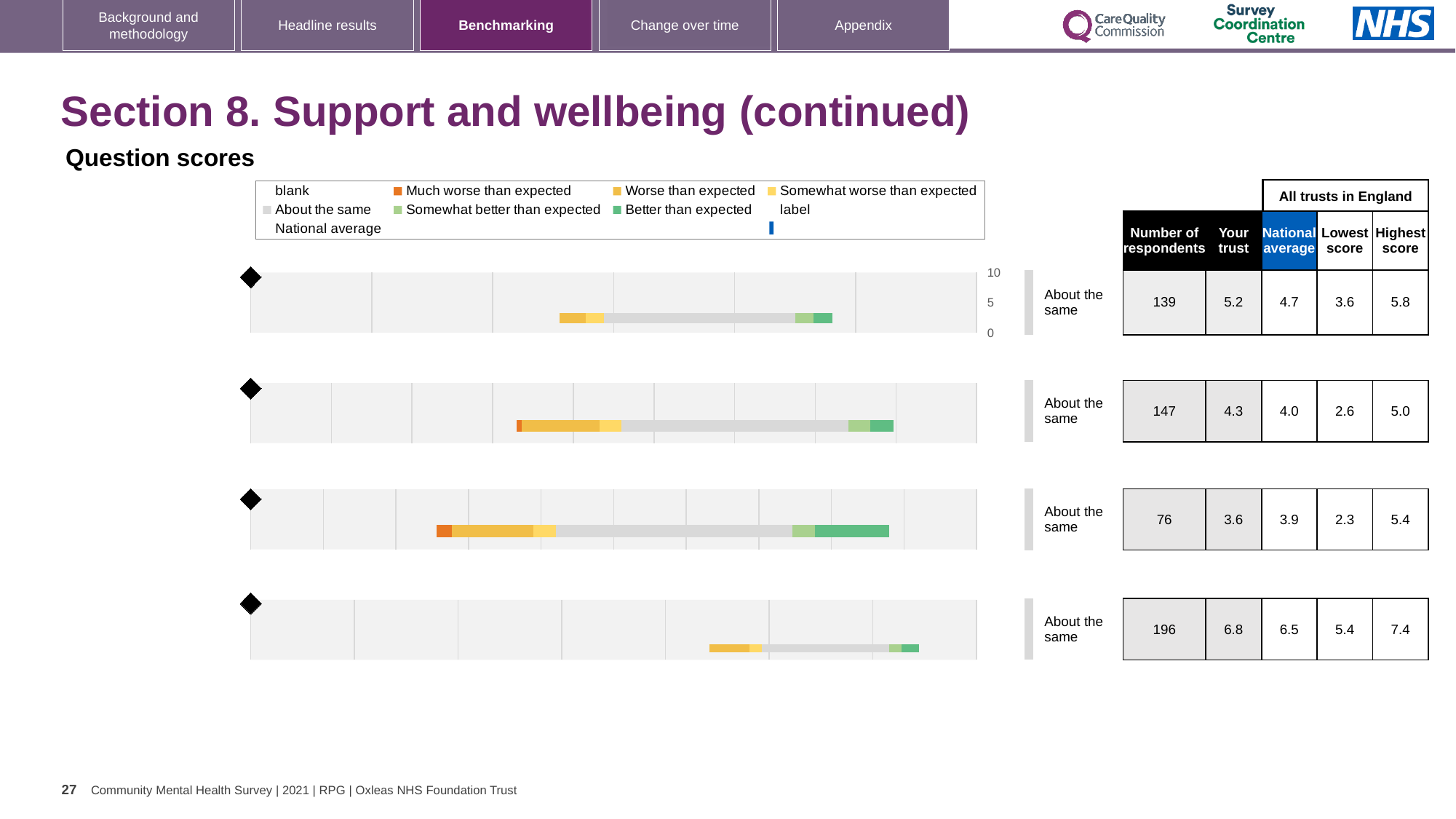
How many benchmarking charts are shown on the slide? 4 For the fourth (bottom) chart, what is the highest score among all trusts in England? 7.4 For the third chart from the top, is the 'Your trust' score higher or lower than the national average? lower What kind of chart is used for the benchmarking displays on this slide? bar chart For the fourth (bottom) chart, what is the difference between the 'Your trust' score and the national average? 0.3 For the first (top) chart, what is the 'Your trust' score shown in the table? 5.2 For the third chart from the top, what is the lowest score among all trusts in England? 2.3 Which chart has the highest 'Your trust' score? the fourth (bottom) chart, 6.8 For the first (top) chart, is the 'Your trust' score greater or less than 5? greater What benchmark category label is shown next to all four charts? About the same For the second chart from the top, how many respondents are listed? 147 For the first (top) chart, what is the national average score? 4.7